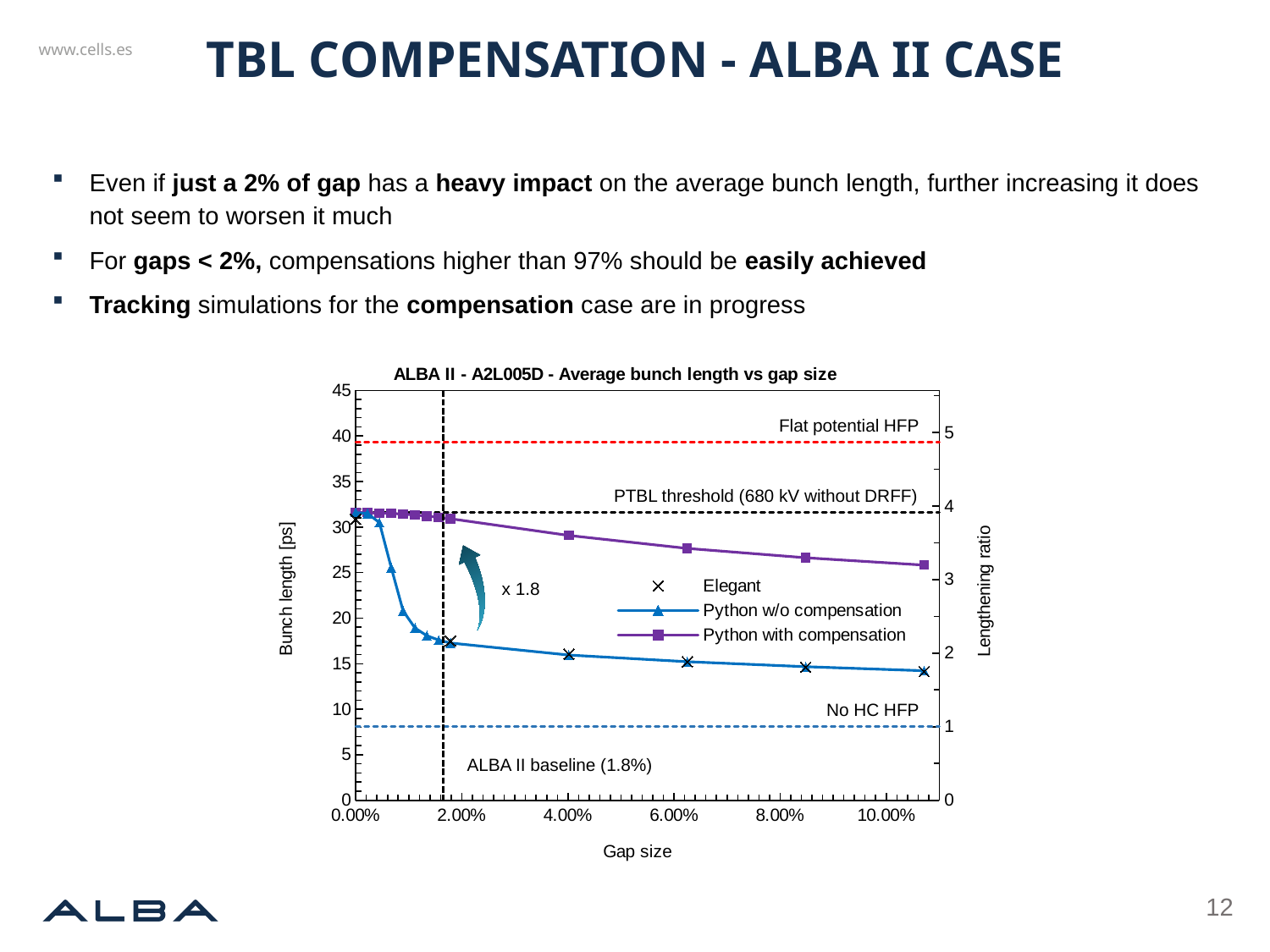
Is the bunch length for 'Python with compensation' at a gap size of 4.00% greater or less than 25? greater Is the bunch length for 'Python w/o compensation' at a gap size of 4.00% greater or less than 20? less Is the 'Flat potential HFP' dashed line above or below a bunch length of 35? above Does the 'Python w/o compensation' series rise or fall as gap size increases? fall At a gap size of 4.00%, which series has the higher bunch length: 'Python with compensation' or 'Python w/o compensation'? Python with compensation What is the title of the chart? ALBA II - A2L005D - Average bunch length vs gap size How many series does the chart legend list? 3 What kind of chart is shown on the slide? line chart What is the label of the left vertical axis? Bunch length [ps] Does the 'Python with compensation' series rise or fall as gap size increases? fall